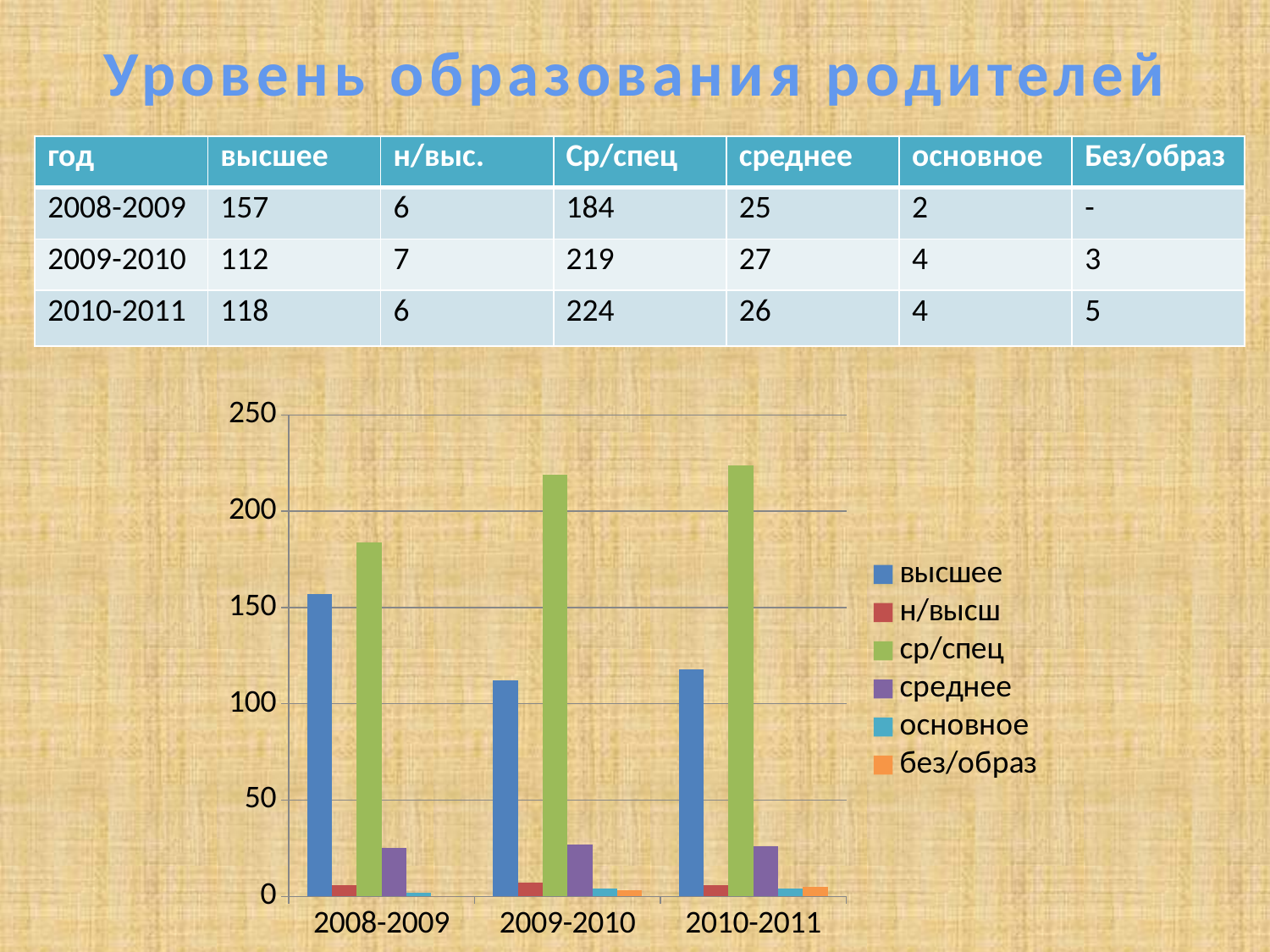
Which series has the tallest bar in every year group? ср/спец Which is larger in 2008-2009: the bar for высшее or the bar for ср/спец? ср/спец Is the value for высшее in 2010-2011 greater or less than 150? less How many year categories are shown on the x axis of the chart? 3 Does the bar for ср/спец rise or fall from 2008-2009 to 2010-2011? rise Is the value for ср/спец in 2009-2010 greater or less than 200? greater What colour is the bar for ср/спец in the chart? green Is the value for ср/спец in 2008-2009 greater or less than 200? less In which year is the bar for высшее the highest? 2008-2009 In which year is the bar for высшее the lowest? 2009-2010 What kind of chart is shown on the slide? bar chart How many series does the chart legend list? 6